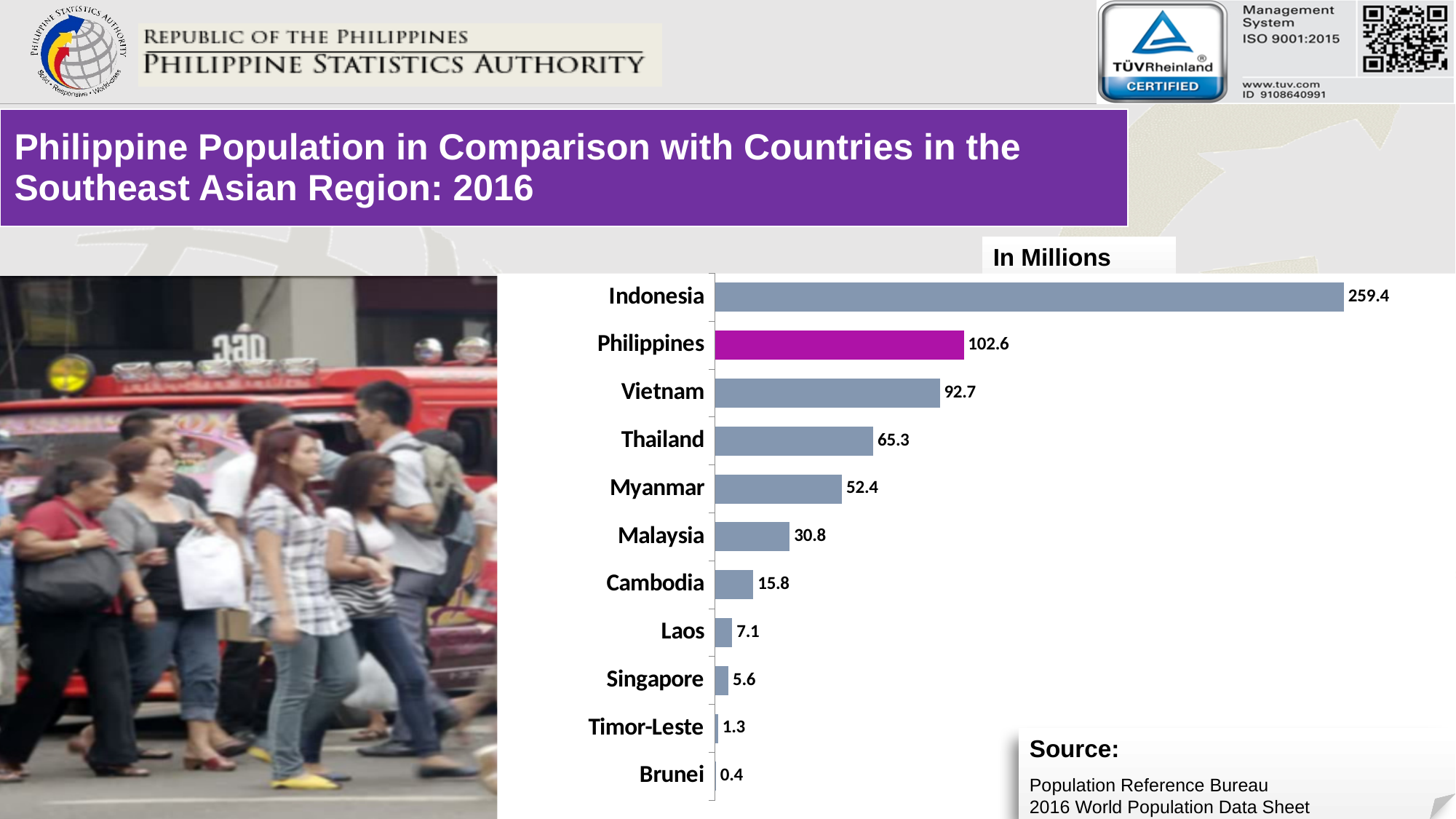
What kind of chart is shown on the slide? Bar chart How many countries are shown in the chart? 11 What is the population value shown for the Philippines? 102.6 What unit are the values in the chart expressed in? In Millions Which country has the lowest population in the chart? Brunei Which country's bar is highlighted in a different colour (magenta) from the others? Philippines What is the difference between the values for Indonesia and the Philippines? 156.8 Which has a larger value, Malaysia or Myanmar? Myanmar Which country has the highest population in the chart? Indonesia What is the population value shown for Vietnam? 92.7 What is the difference between the values for Thailand and Myanmar? 12.9 What is the population value shown for Cambodia? 15.8